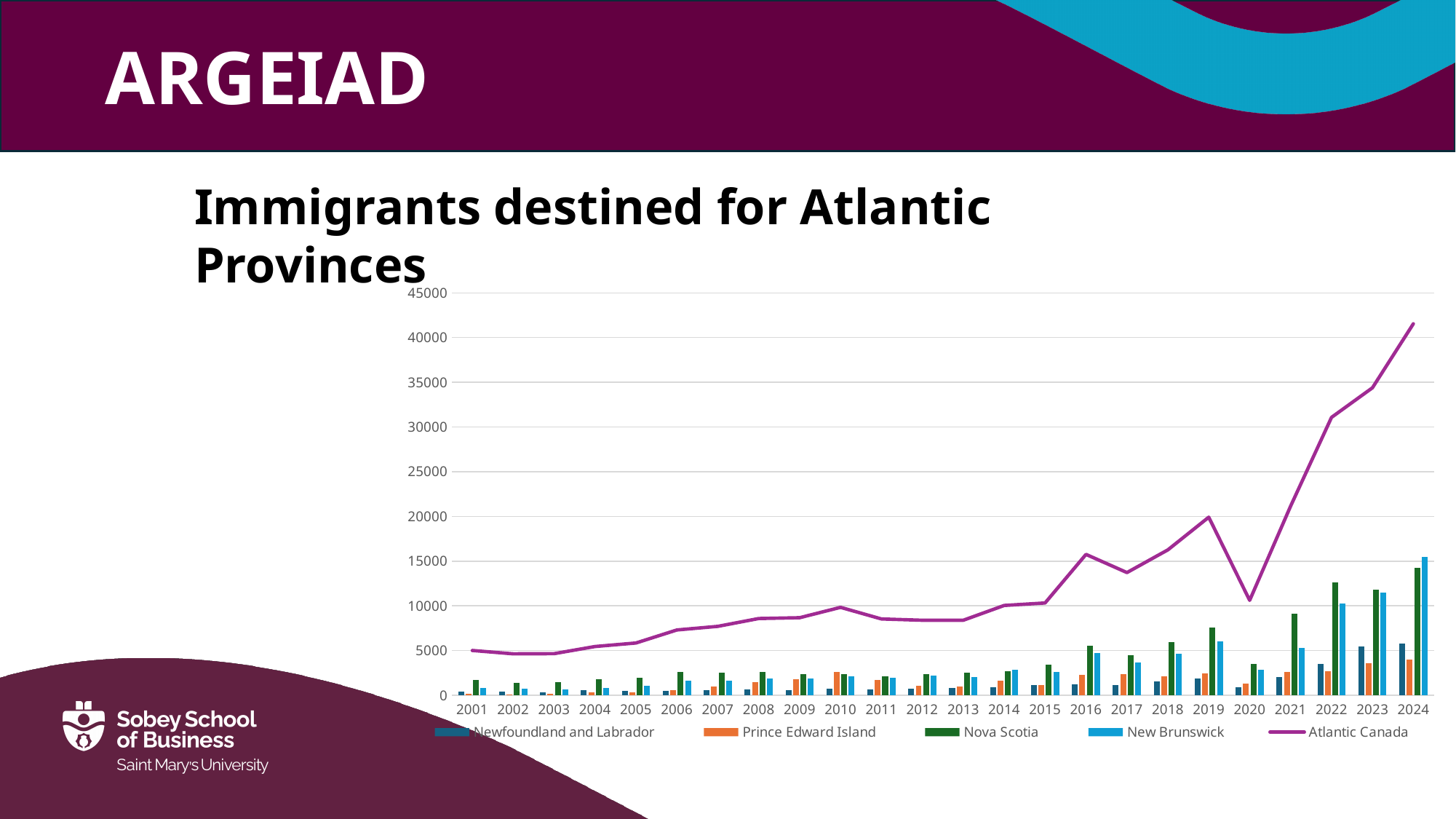
Which series is plotted as a line rather than bars? Atlantic Canada What is the title of the chart? Immigrants destined for Atlantic Provinces Does the Atlantic Canada line generally rise or fall from 2001 to 2024? rise In which year does the Atlantic Canada line reach its highest value? 2024 Is the Atlantic Canada value for 2017 greater or less than 15000? less Is the Atlantic Canada value for 2022 greater or less than 30000? greater How many years are shown along the x axis? 24 Is the Nova Scotia value for 2022 greater or less than 10000? greater In 2024, which is larger: the Nova Scotia bar or the Newfoundland and Labrador bar? Nova Scotia How many series does the legend list? 5 What kind of chart is shown on the slide? A combined bar and line chart